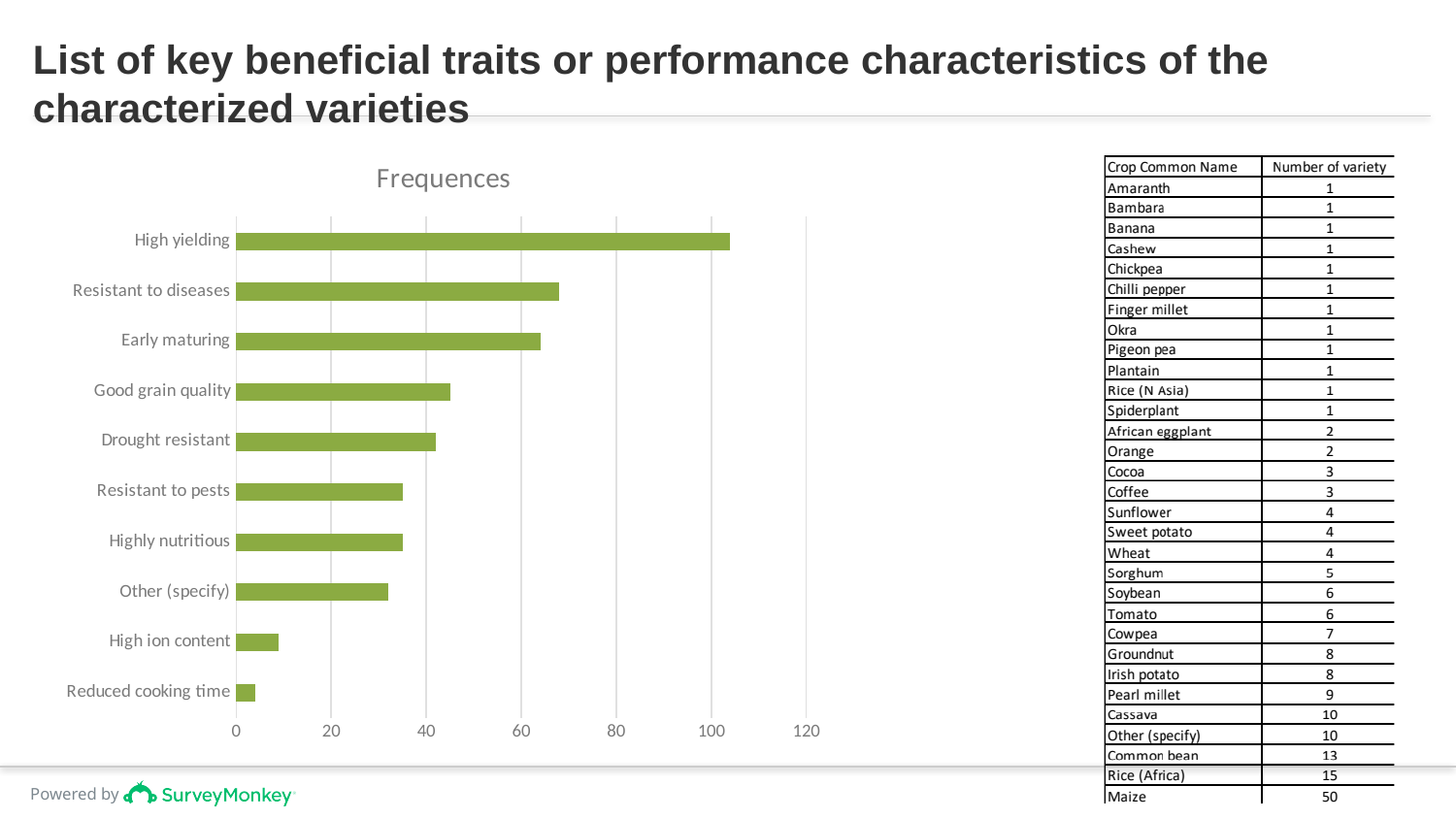
Do the bar lengths increase or decrease going from the top category to the bottom category? decrease Is the value for Good grain quality greater or less than 40? greater Is the value for High yielding greater or less than 100? greater Which category has the highest value in the chart? High yielding Which is larger, the value for Early maturing or the value for Drought resistant? Early maturing How many categories are plotted in the chart? 10 Which is larger, the value for Other (specify) or the value for High ion content? Other (specify) Which category has the lowest value in the chart? Reduced cooking time Is the value for Resistant to diseases greater or less than 60? greater What kind of chart is shown on the slide? bar chart What is the title of the chart? Frequences